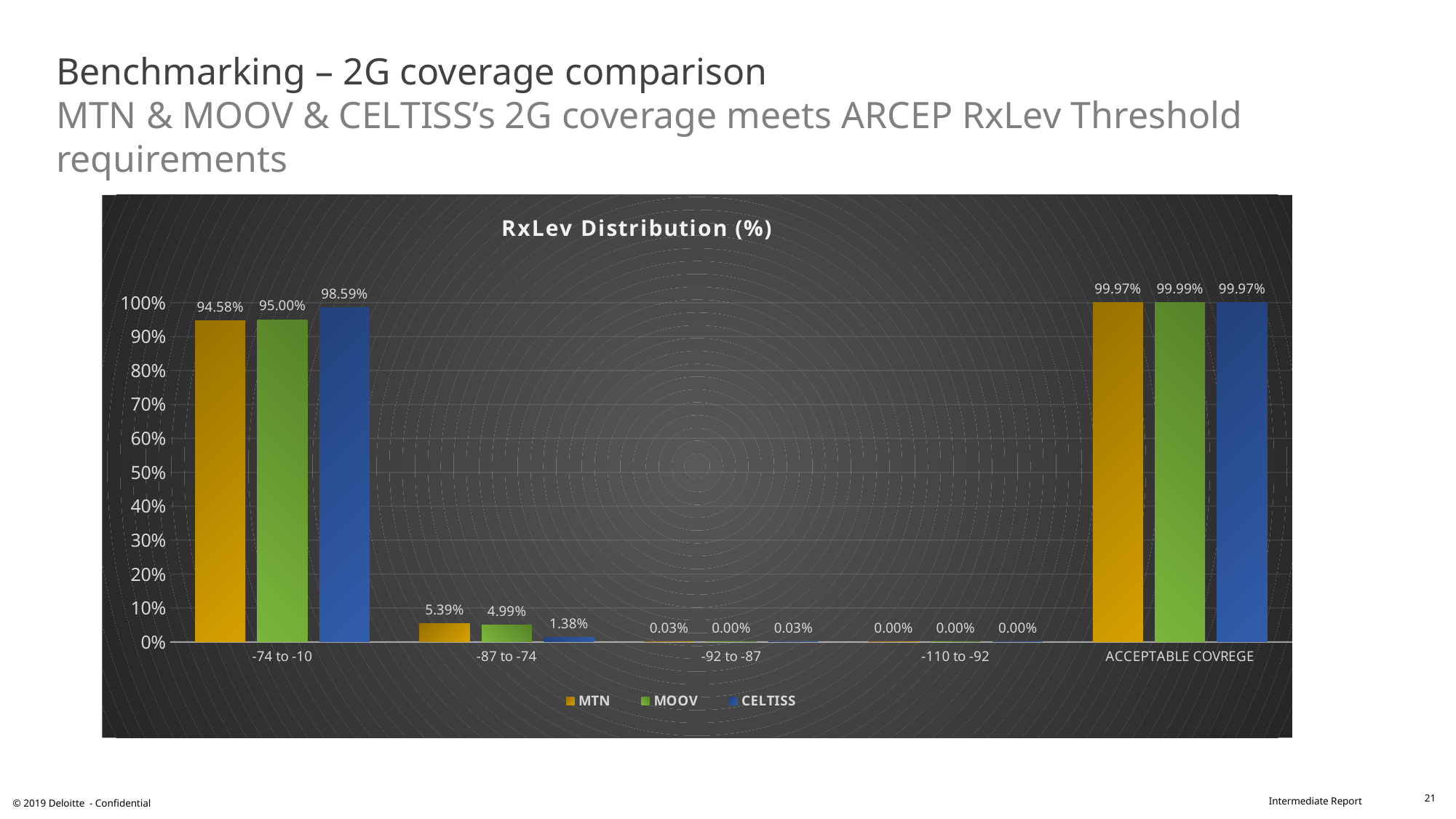
What is the MTN value for the -74 to -10 category? 94.58% What is the MOOV value for ACCEPTABLE COVREGE? 99.99% Which is larger in the -87 to -74 category, MTN or MOOV? MTN What kind of chart is shown on the slide? Bar chart Which series has the highest value in the -74 to -10 category? CELTISS How many series does the legend list? 3 What is the difference between the CELTISS and MTN values in the -74 to -10 category? 4.01% What is the MTN value for the -92 to -87 category? 0.03% What is the CELTISS value for the -87 to -74 category? 1.38% Which series has the lowest value in the -87 to -74 category? CELTISS How many categories are shown on the x axis? 5 What is the title of the chart? RxLev Distribution (%)